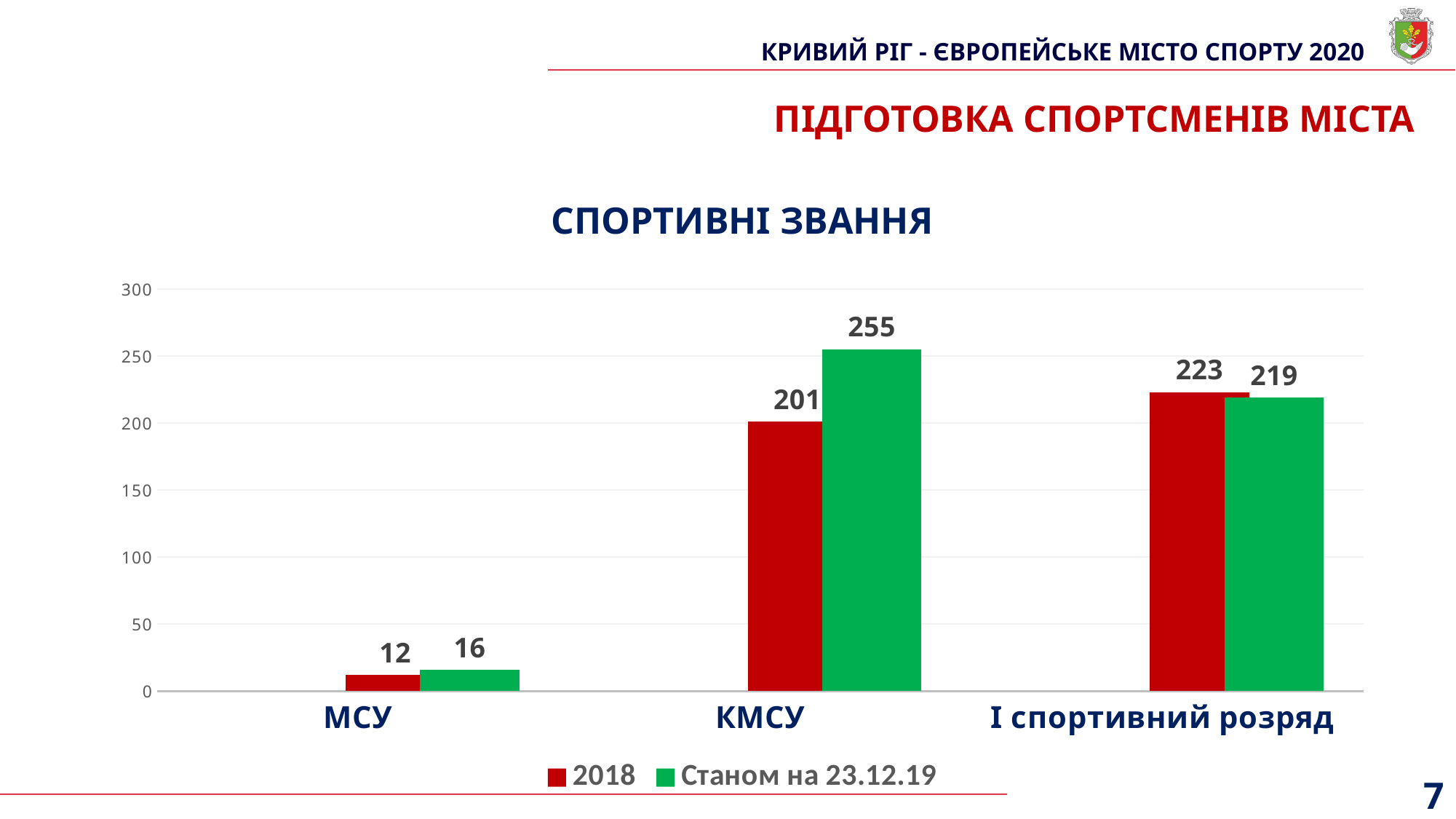
What is the difference between the 'Станом на 23.12.19' and 2018 values for КМСУ? 54 What kind of chart is shown on the slide? Bar chart Which category has the highest value in the 'Станом на 23.12.19' series? КМСУ What is the title of the chart? СПОРТИВНІ ЗВАННЯ How many series does the legend list? 2 Which category has the lowest value in the 2018 series? МСУ What is the value for І спортивний розряд in the 2018 series? 223 What is the value for МСУ in the 'Станом на 23.12.19' series? 16 How many categories are shown on the x axis? 3 What is the value for КМСУ in the 2018 series? 201 For МСУ, which series has the larger value: 2018 or 'Станом на 23.12.19'? Станом на 23.12.19 What is the difference between the 2018 and 'Станом на 23.12.19' values for І спортивний розряд? 4